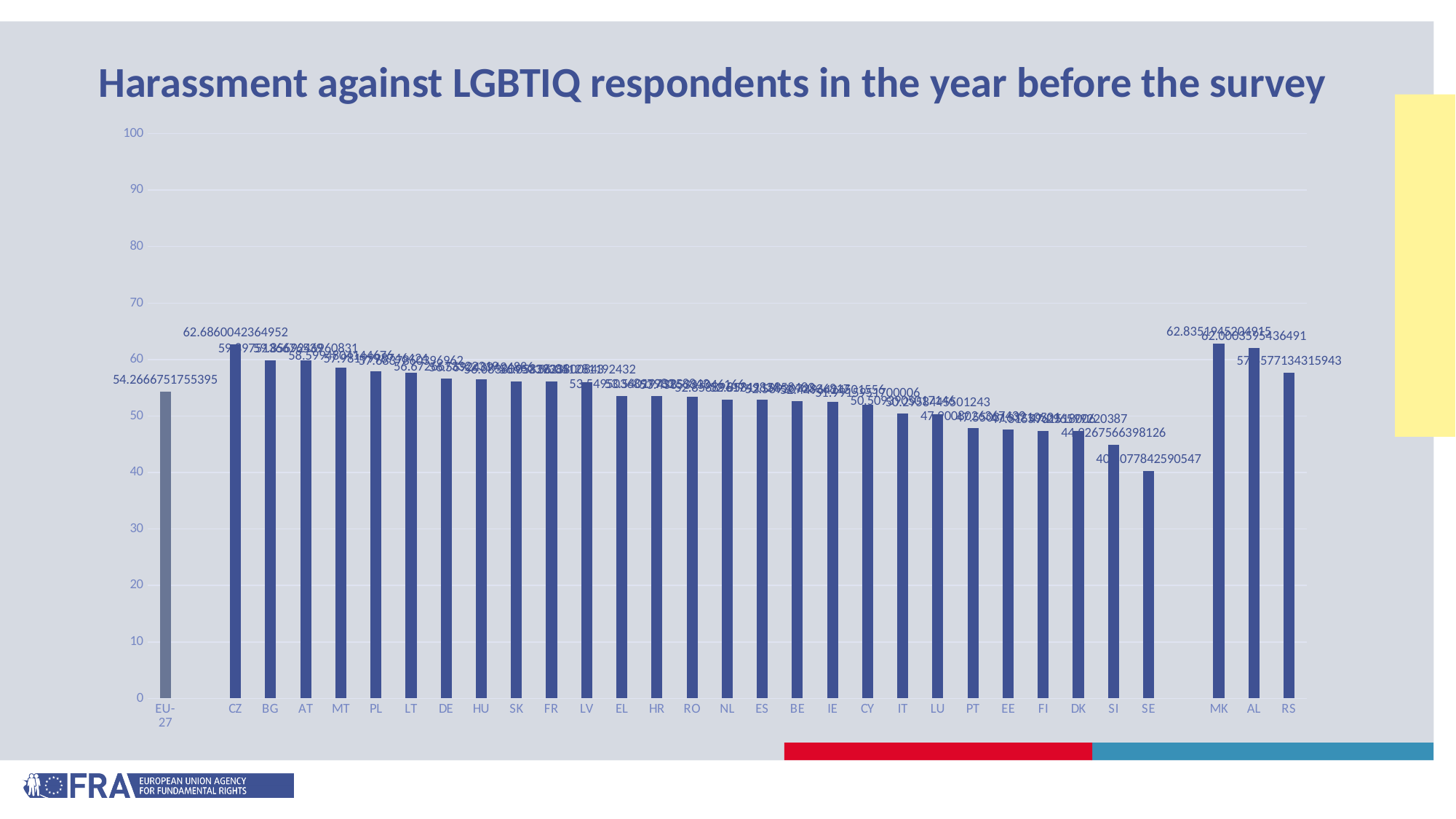
How many categories (countries/groups) are shown on the x axis? 31 Which is larger, the value for CZ or the value for SE? CZ Is the value for DK greater or less than 50? less What is the title of the chart? Harassment against LGBTIQ respondents in the year before the survey What is the value shown for MK? 62.8351945204915 Which category has the lowest value? SE Is the value for SE greater or less than 50? less What is the value shown for CZ? 62.6860042364952 Do the values generally rise or fall along the x axis from CZ to SE? fall What kind of chart is shown on the slide? bar chart What is the value shown for EU-27? 54.2666751755395 Is the value for AL greater or less than 60? greater